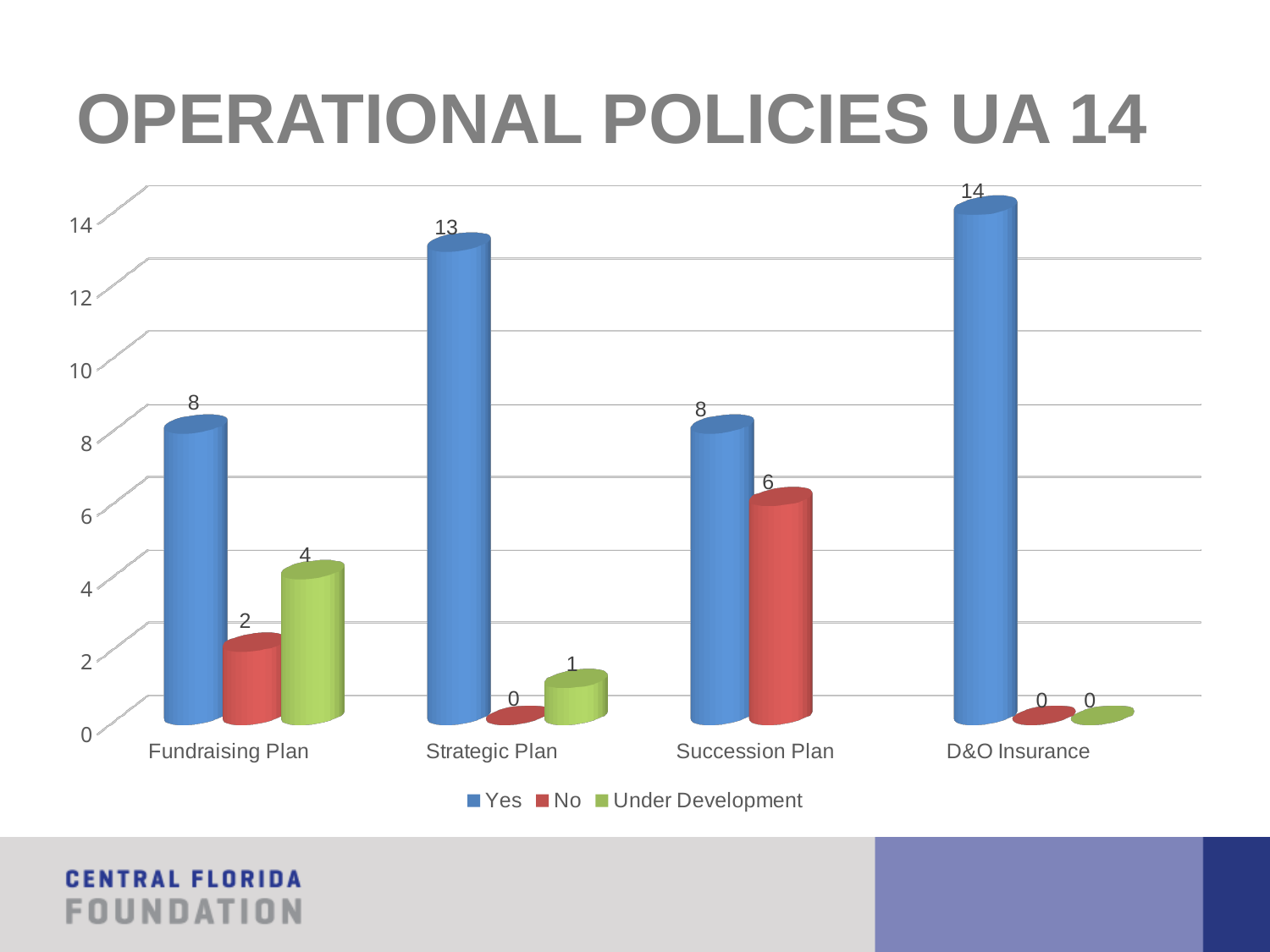
Which category has the highest value for Yes? D&O Insurance What kind of chart is shown on the slide? bar chart What is the value for No for Fundraising Plan? 2 Which is larger, the No value for Succession Plan or the No value for Fundraising Plan? Succession Plan What is the value for Yes for Strategic Plan? 13 Is the Yes value for Strategic Plan greater or less than 10? greater What is the value for Under Development for Fundraising Plan? 4 What is the difference between the Yes value for D&O Insurance and the Yes value for Strategic Plan? 1 Which category has the lowest value for Yes? Fundraising Plan and Succession Plan What is the value for No for Succession Plan? 6 How many categories are shown on the x axis? 4 How many series does the legend list? 3